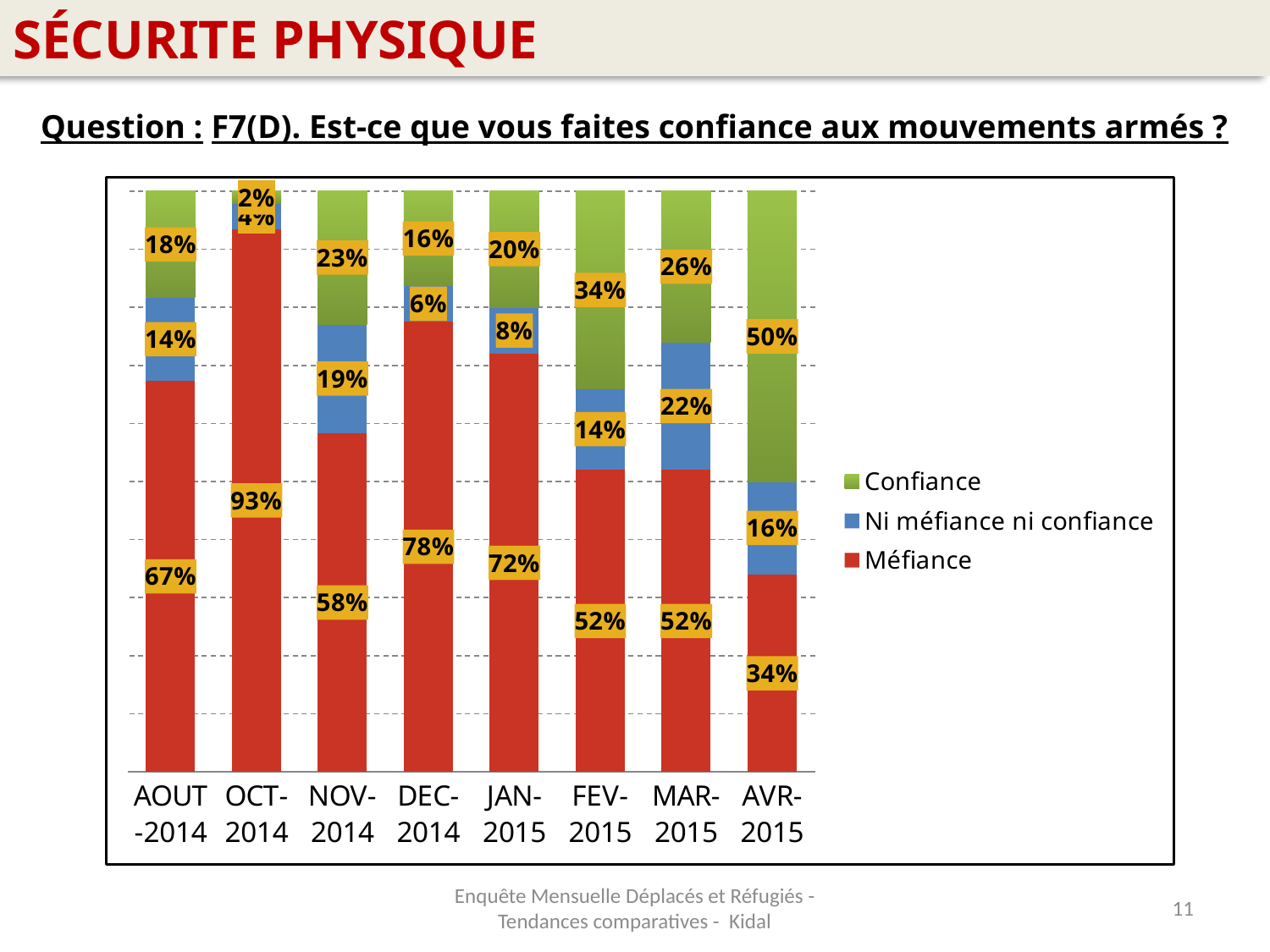
What is the Ni méfiance ni confiance value for MAR-2015? 22% Which series is shown in red? Méfiance What is the difference between the Méfiance values for DEC-2014 and JAN-2015? 6% How many months are shown on the x axis? 8 In which month is the Méfiance value lowest? AVR-2015 Which is larger, the Confiance value for FEV-2015 or for MAR-2015? FEV-2015 What is the Confiance value for AVR-2015? 50% What type of chart is shown on the slide? stacked bar chart In which month is the Confiance value highest? AVR-2015 In which month is the Méfiance value highest? OCT-2014 How many series does the legend list? 3 What is the Méfiance value for OCT-2014? 93%